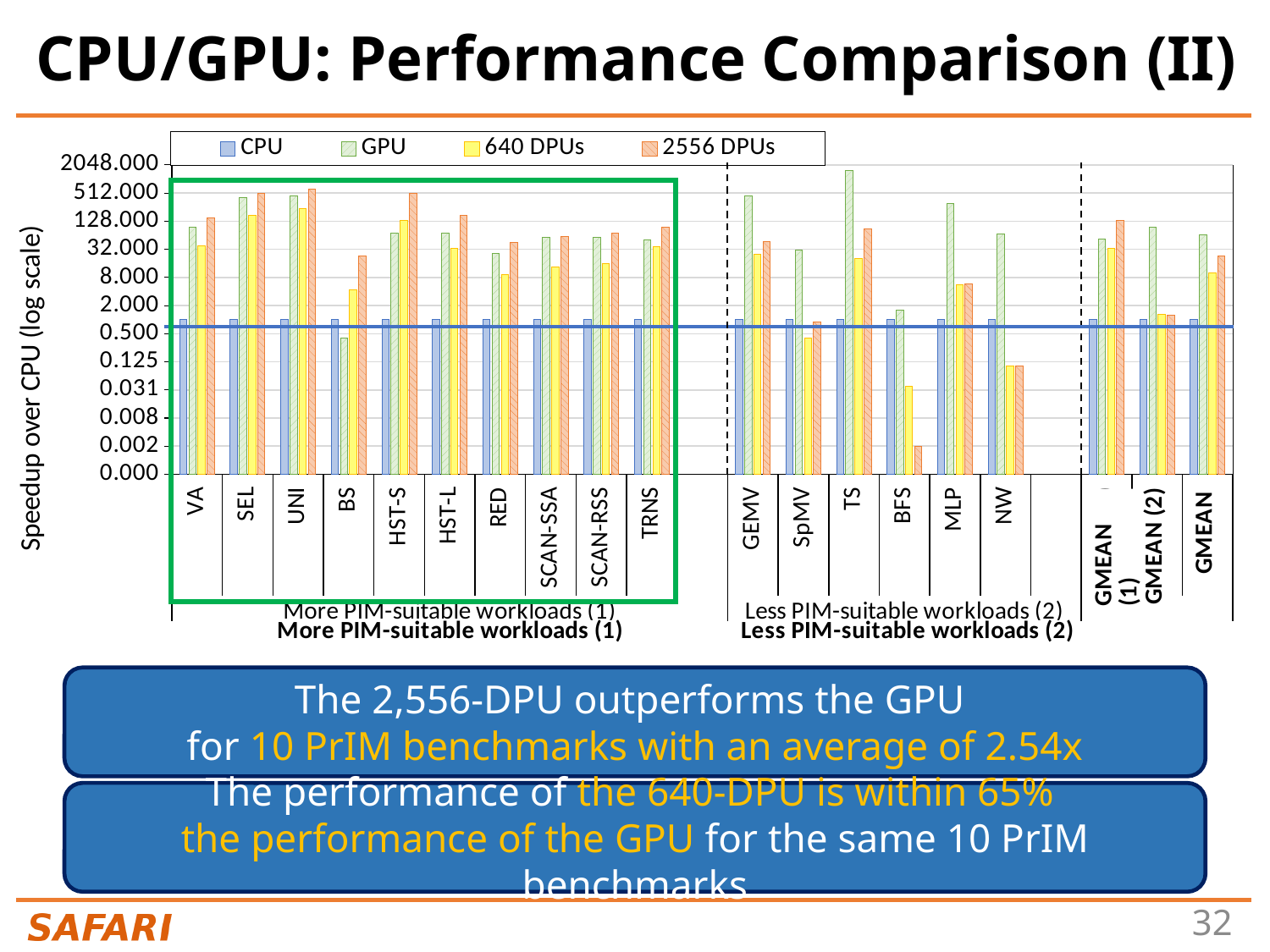
How many series does the chart legend list? 4 Which category has the lowest 2556 DPUs bar in the chart? BFS Is the GPU value for TS greater or less than 512? greater What is the label of the chart's y axis? Speedup over CPU (log scale) For TS, which is larger: the GPU value or the 2556 DPUs value? GPU What are the four series listed in the chart legend? CPU, GPU, 640 DPUs, 2556 DPUs Which category has the highest GPU bar in the chart? TS How many workload categories are plotted along the x axis of the chart? 19 For BS, which is larger: the GPU value or the 2556 DPUs value? 2556 DPUs Which category has the lowest GPU bar in the chart? BS What kind of chart is shown on the slide? bar chart Is the 640 DPUs value for BS greater or less than 8? less